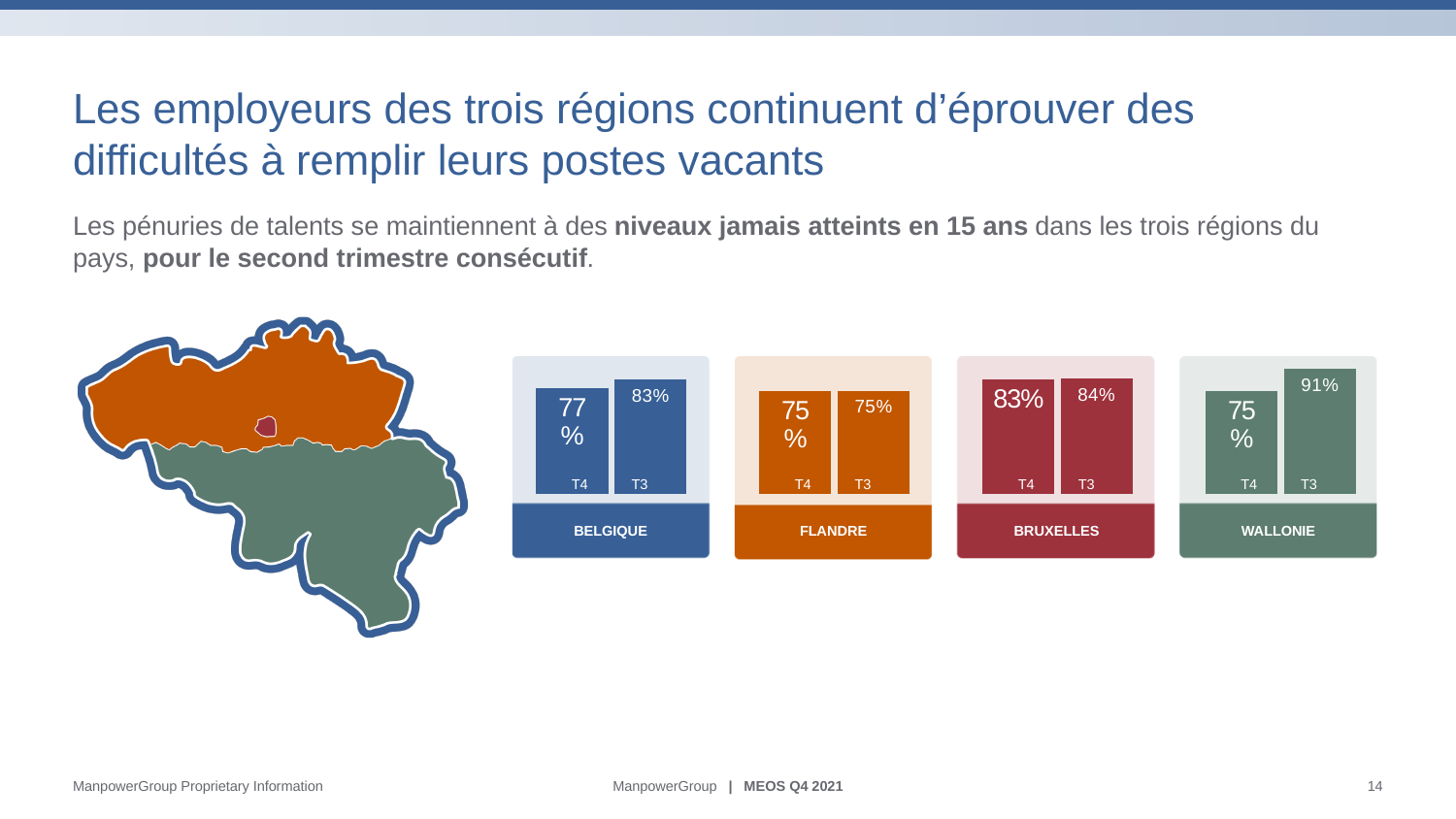
In the FLANDRE chart, what is the value for T3? 75% In the WALLONIE chart, what is the difference between the T3 and T4 values? 16 percentage points In the WALLONIE chart, which bar is the highest? T3 What kind of chart is used for each region on the slide? Bar chart In the BELGIQUE chart, what is the value for T4? 77% In the BRUXELLES chart, what is the value for T4? 83% In the BELGIQUE chart, what is the value for T3? 83% In the BELGIQUE chart, which is larger, T4 or T3? T3 In the WALLONIE chart, what is the value for T3? 91% In the BELGIQUE chart, what is the difference between the T3 and T4 values? 6 percentage points How many bars are shown in the FLANDRE chart? 2 In the WALLONIE chart, what is the value for T4? 75%